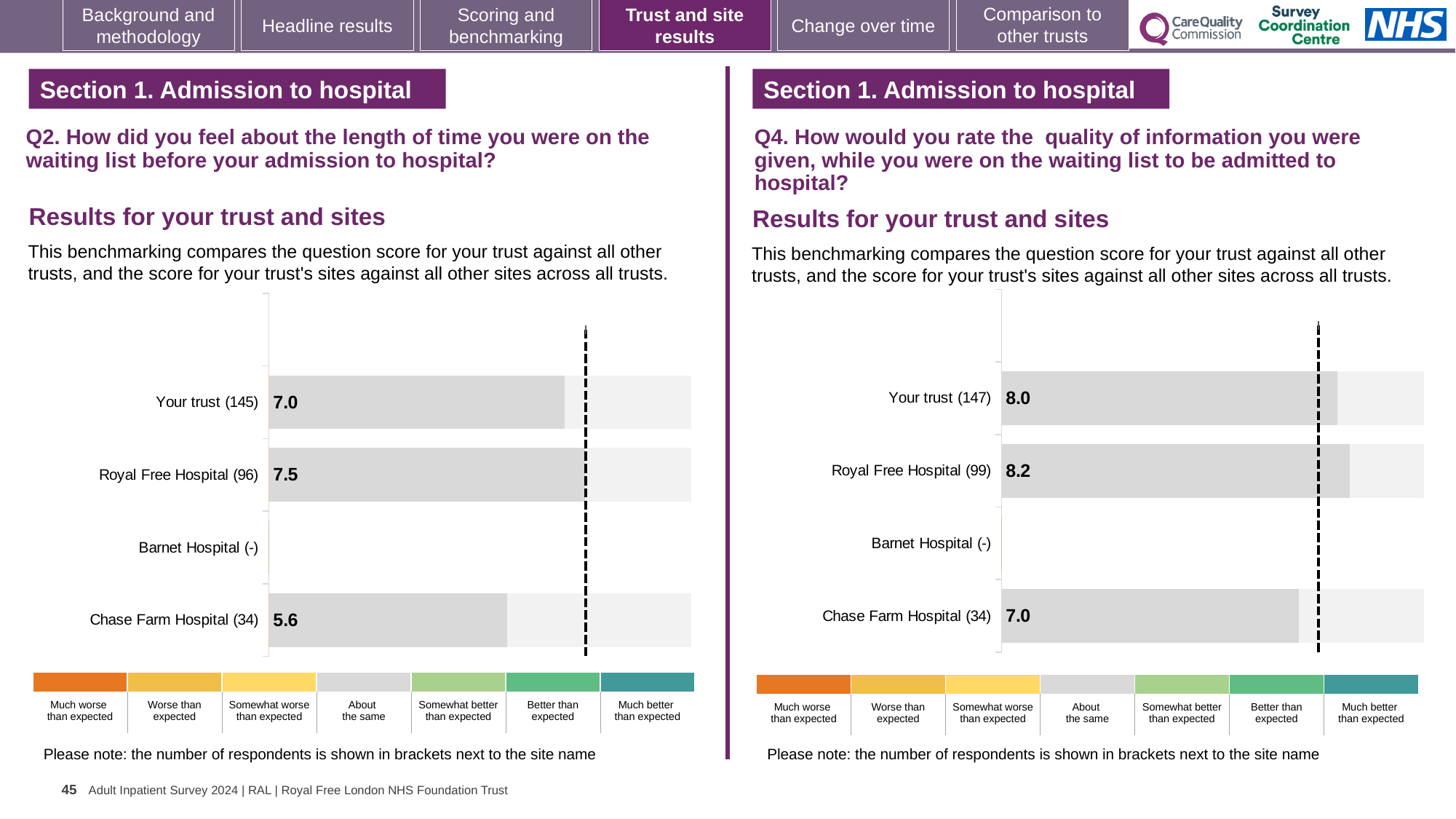
What type of chart is used on the right side of the slide (Q4)? Bar chart On the left chart (Q2), how many categories are listed on the vertical axis? 4 On the left chart (Q2), what is the score for Royal Free Hospital (96)? 7.5 On the right chart (Q4), which has the larger score, Your trust (147) or Chase Farm Hospital (34)? Your trust (147) On the left chart (Q2), which site or trust has the lowest score? Chase Farm Hospital (34) On the left chart (Q2), what is the score for Your trust (145)? 7.0 On the right chart (Q4), what is the score for Your trust (147)? 8.0 On the right chart (Q4), what is the score for Royal Free Hospital (99)? 8.2 On the right chart (Q4), what is the score for Chase Farm Hospital (34)? 7.0 On the left chart (Q2), what is the score for Chase Farm Hospital (34)? 5.6 On the left chart (Q2), what is the difference between the scores for Royal Free Hospital (96) and Chase Farm Hospital (34)? 1.9 On the right chart (Q4), which site or trust has the highest score? Royal Free Hospital (99)